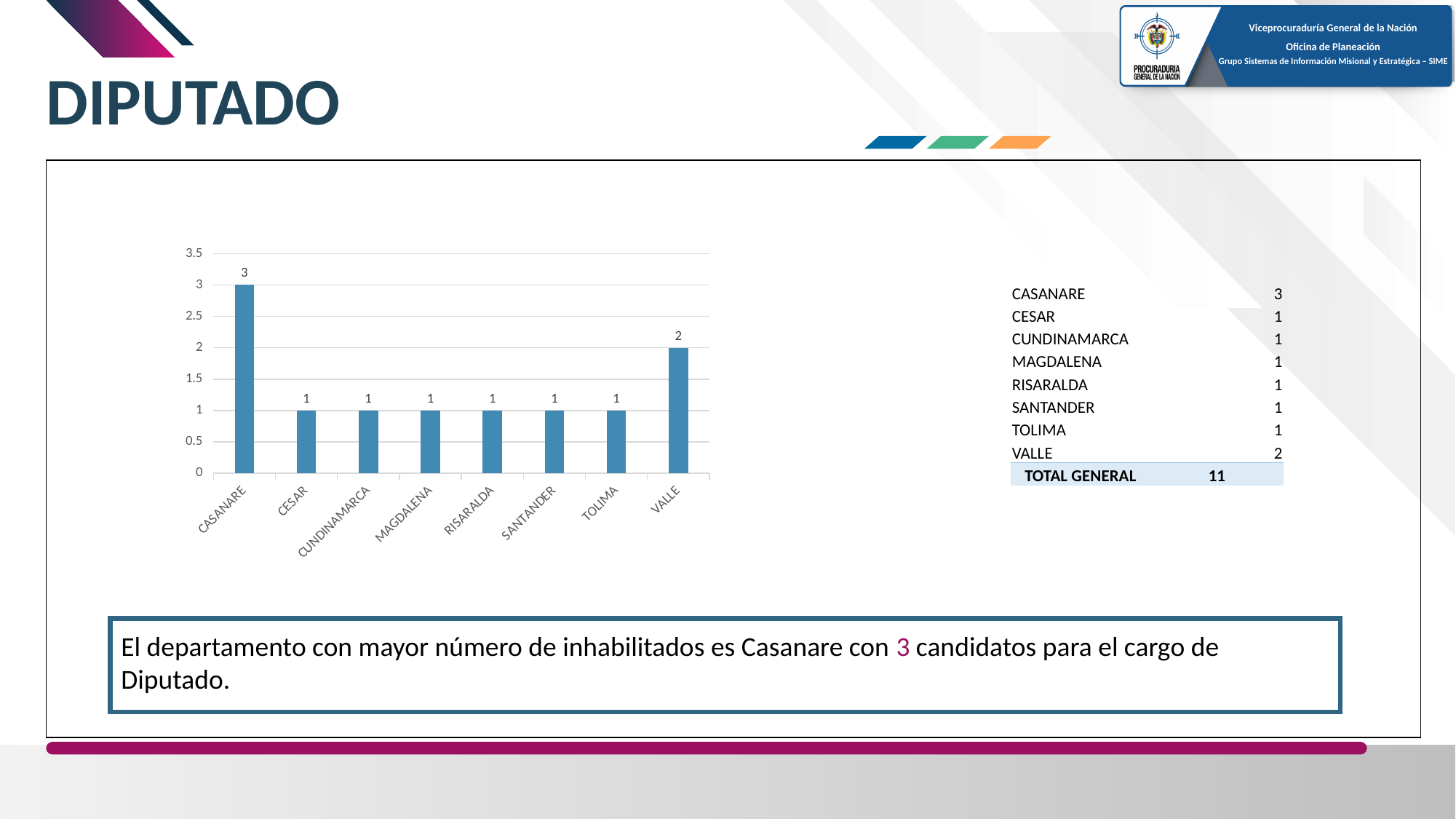
Which category has the highest value in the bar chart? CASANARE What is the total of all the values shown in the bar chart? 11 Is the value for MAGDALENA greater or less than 1.5? less Which is larger, the value for VALLE or the value for SANTANDER? VALLE What is the value for CASANARE in the bar chart? 3 How many categories are shown on the x axis of the bar chart? 8 Is the value for CASANARE greater or less than 2.5? greater What is the value for VALLE in the bar chart? 2 What is the value for TOLIMA in the bar chart? 1 What is the difference between the values for VALLE and CESAR? 1 What kind of chart is shown on the slide? bar chart What is the difference between the values for CASANARE and VALLE? 1